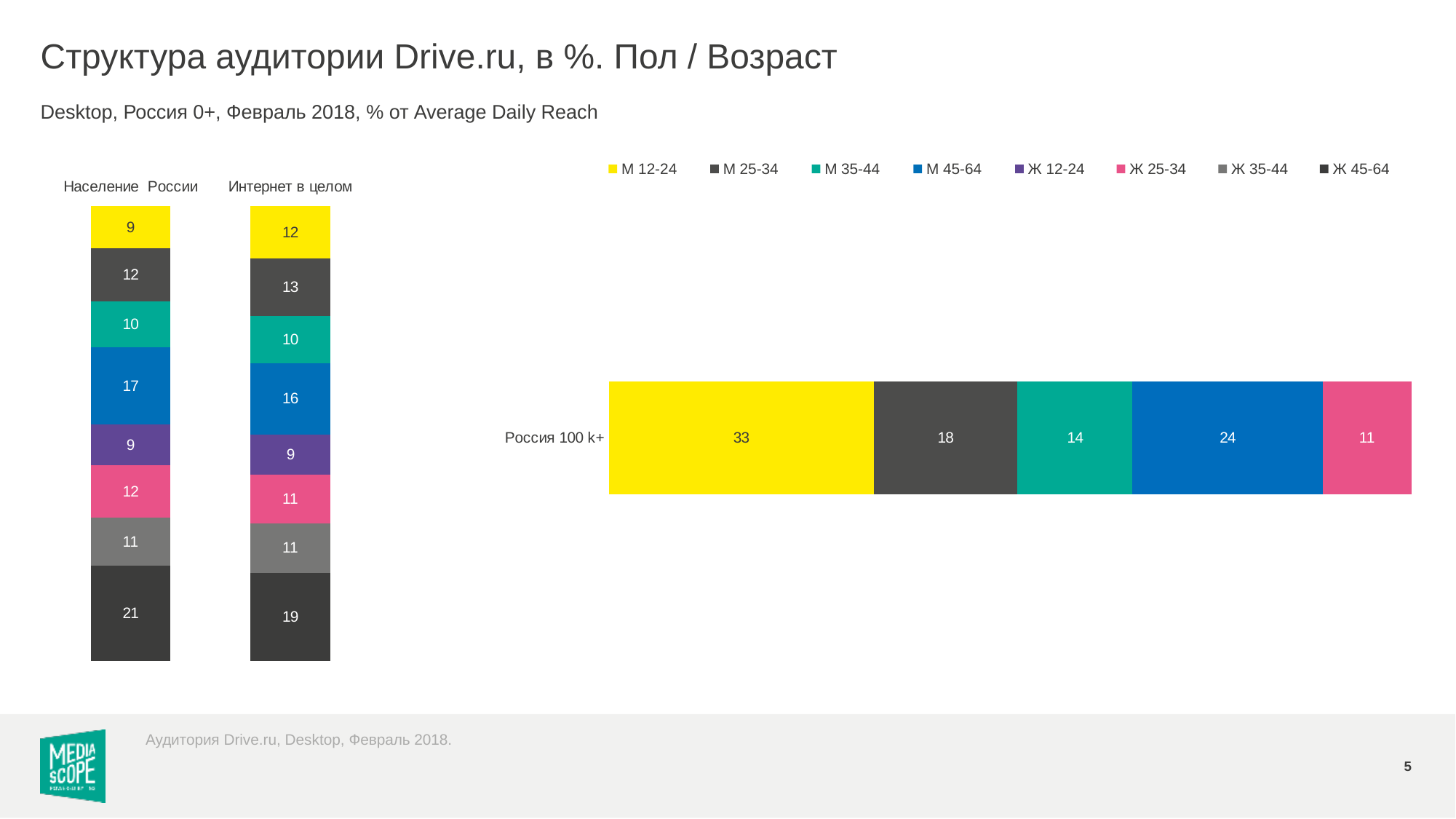
In the right chart, which segment of the Россия 100 k+ bar is the smallest? Ж 25-34 In the left chart, which segment of the Население России bar is the largest? Ж 45-64 How many series does the legend list? 8 In the right chart, what is the value for М 12-24 in the Россия 100 k+ bar? 33 In the left chart, what is the value for Ж 45-64 in the Интернет в целом bar? 19 In the left chart, what is the value for М 45-64 in the Население России bar? 17 In the right chart, what is the value for М 45-64 in the Россия 100 k+ bar? 24 In the left chart, what is the difference between the М 12-24 values for Интернет в целом and Население России? 3 What type of chart is the right chart? Stacked bar chart In the left chart, which is larger: М 45-64 for Население России or М 45-64 for Интернет в целом? Население России In the right chart, which segment of the Россия 100 k+ bar is the largest? М 12-24 In the right chart, what is the difference between the М 12-24 and М 25-34 values for Россия 100 k+? 15